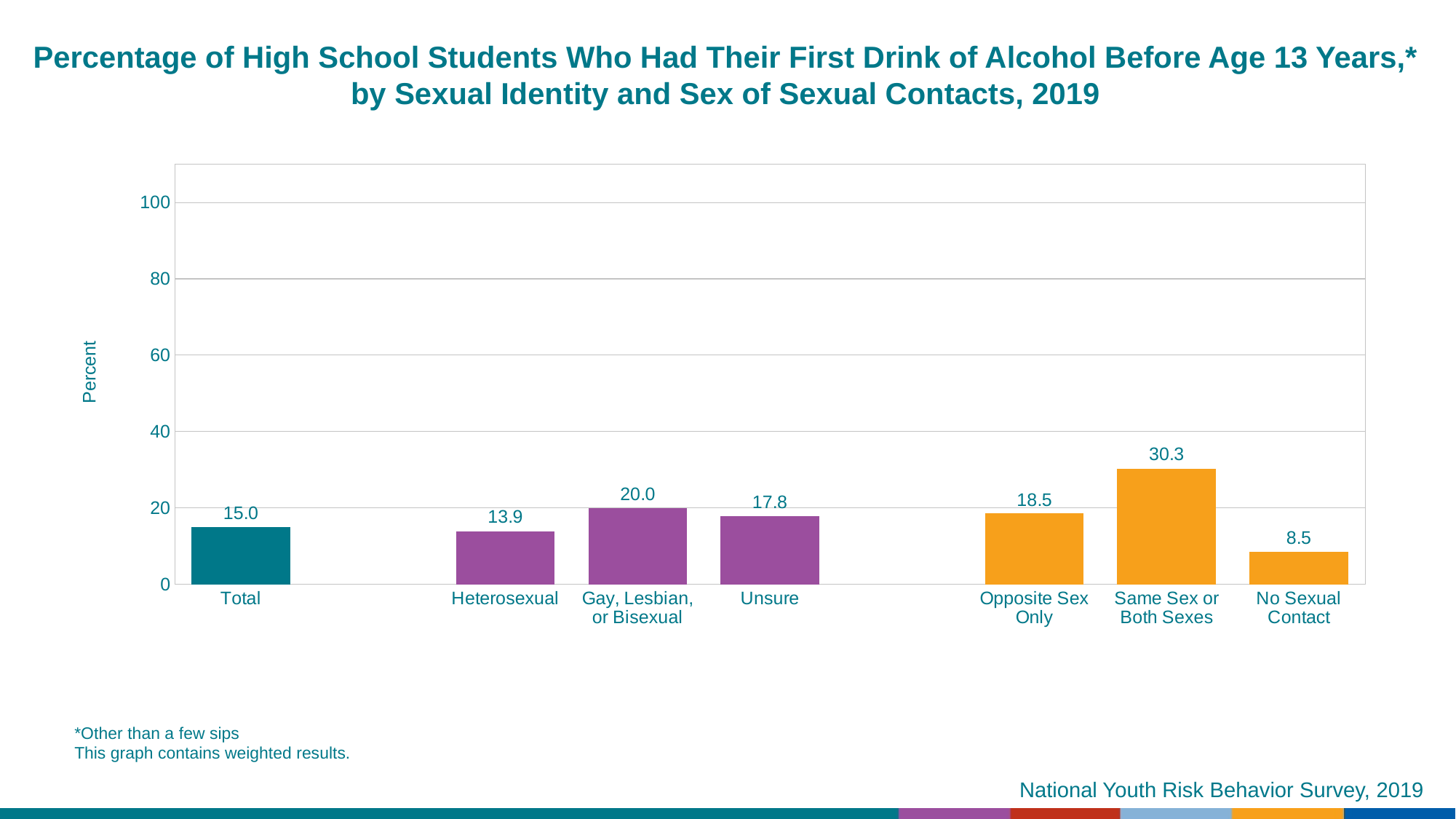
What is the value for Heterosexual? 13.9 Is the value for Same Sex or Both Sexes greater or less than 20? greater What is the label of the y axis? Percent Which category has the highest value? Same Sex or Both Sexes What is the difference between the values for Same Sex or Both Sexes and Opposite Sex Only? 11.8 What is the value for Total? 15.0 What is the value for No Sexual Contact? 8.5 Which category has the lowest value? No Sexual Contact How many categories are shown on the x axis? 7 What is the value for Same Sex or Both Sexes? 30.3 What kind of chart is shown on the slide? bar chart Which is larger, the value for Gay, Lesbian, or Bisexual or the value for Unsure? Gay, Lesbian, or Bisexual